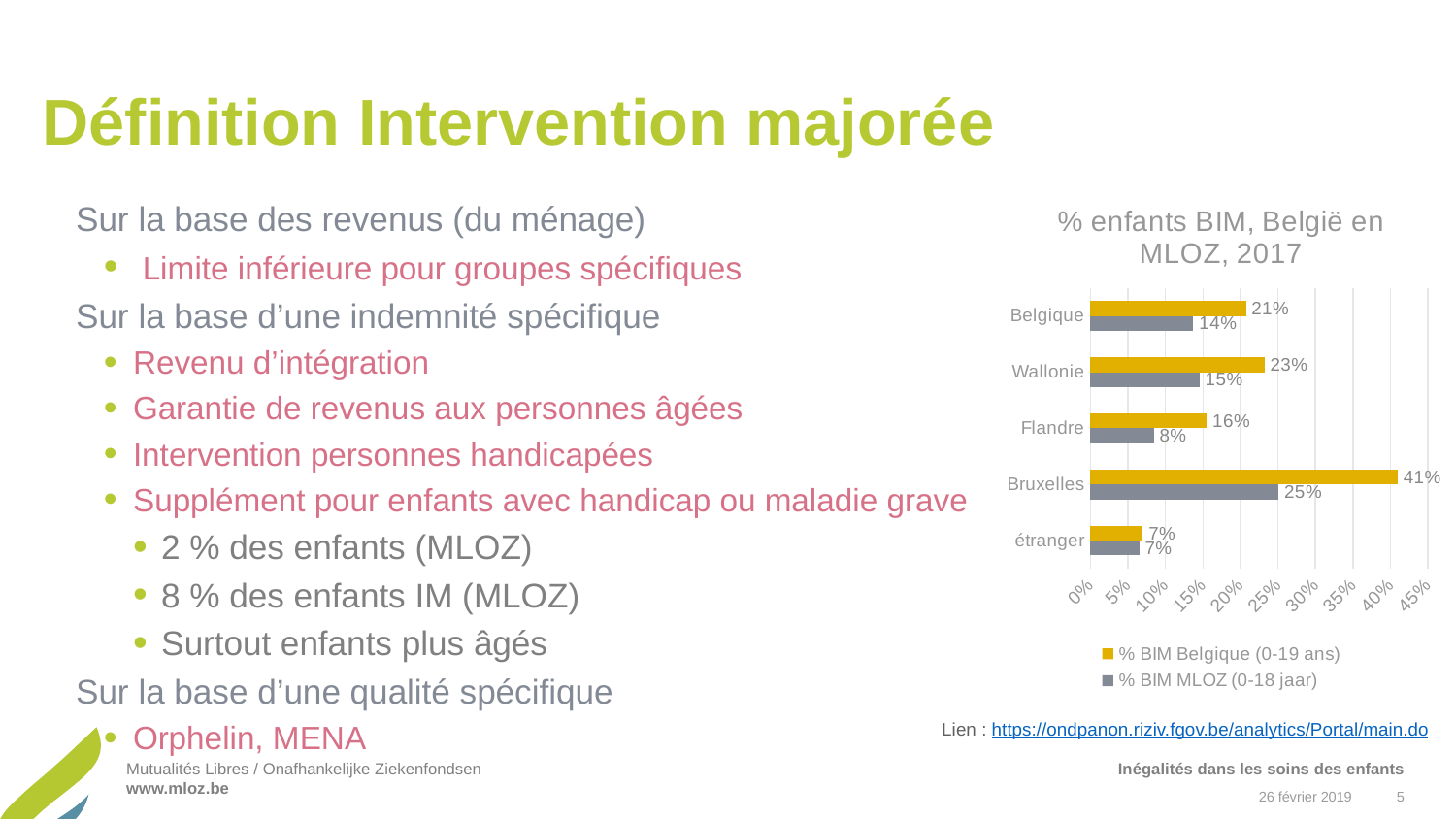
What is the value of % BIM Belgique (0-19 ans) for Bruxelles? 41% What is the value of % BIM MLOZ (0-18 jaar) for Wallonie? 15% What is the title of the chart? % enfants BIM, België en MLOZ, 2017 What kind of chart is shown on the slide? Bar chart Which category has the lowest value for % BIM MLOZ (0-18 jaar)? étranger How many series does the legend list? 2 How many categories are shown on the chart? 5 What is the value of % BIM MLOZ (0-18 jaar) for Flandre? 8% Which is larger for Flandre: % BIM Belgique (0-19 ans) or % BIM MLOZ (0-18 jaar)? % BIM Belgique (0-19 ans) Which category has the highest value for % BIM Belgique (0-19 ans)? Bruxelles What is the difference between the % BIM Belgique (0-19 ans) and % BIM MLOZ (0-18 jaar) values for Bruxelles? 16% What is the difference between the % BIM Belgique (0-19 ans) values for Wallonie and Flandre? 7%